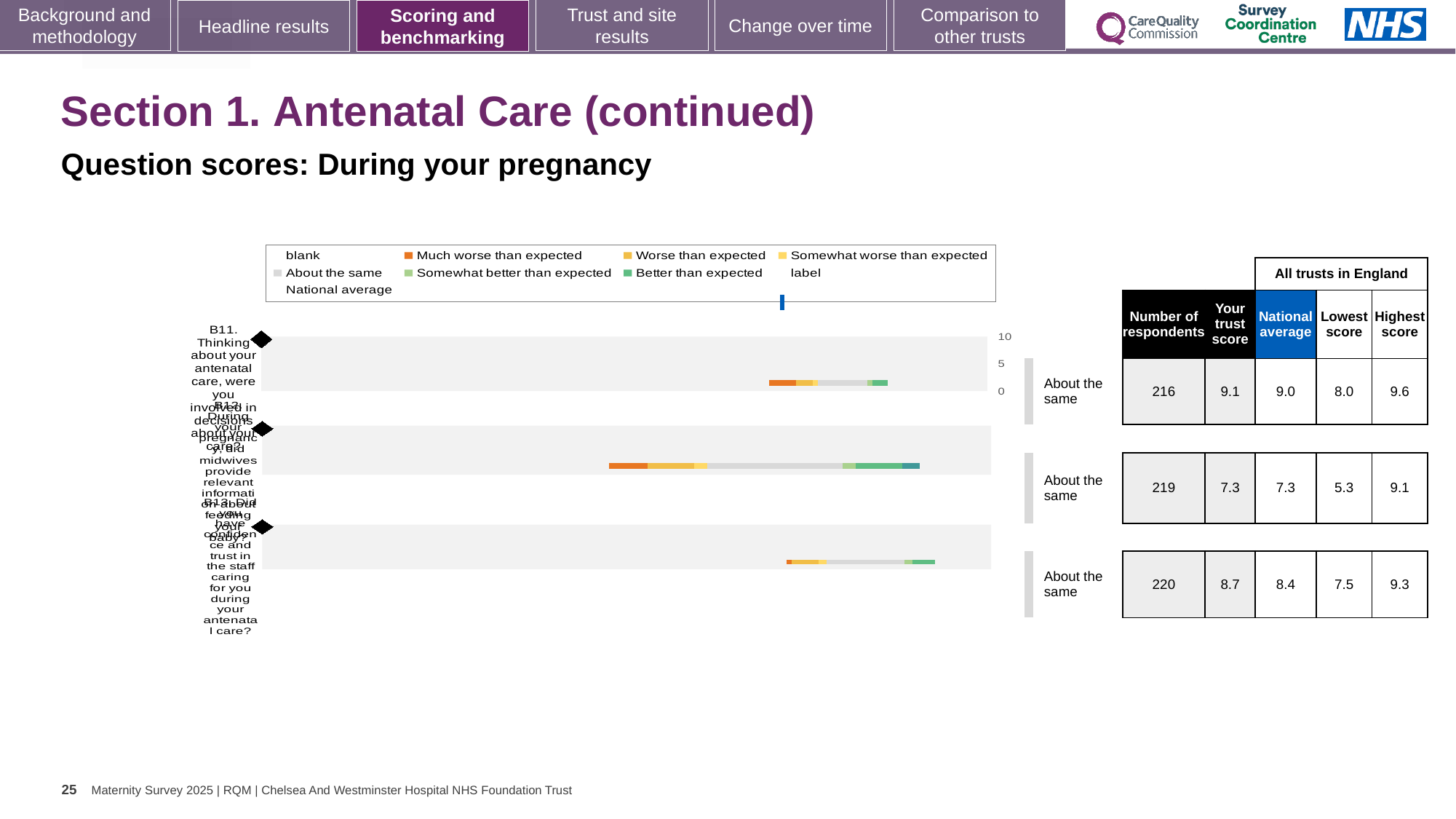
How many question rows (categories) are plotted in the chart? 3 What is the lowest score among all trusts in England for question B12? 5.3 What benchmark category is shown for all three questions? About the same What is the trust score for question B11 (involved in decisions about your antenatal care)? 9.1 How many respondents answered question B13 (confidence and trust in the staff caring for you during antenatal care)? 220 What kind of chart is shown on the slide? bar chart What is the difference between the highest score and the lowest score for question B13? 1.8 Is the trust score for question B11 larger or smaller than the national average for B11? larger What is the difference between the trust score and the national average for question B13? 0.3 What is the national average for question B12 (midwives provide relevant information about feeding your baby)? 7.3 Which question has the lowest trust score? B12 Which question has the highest trust score? B11